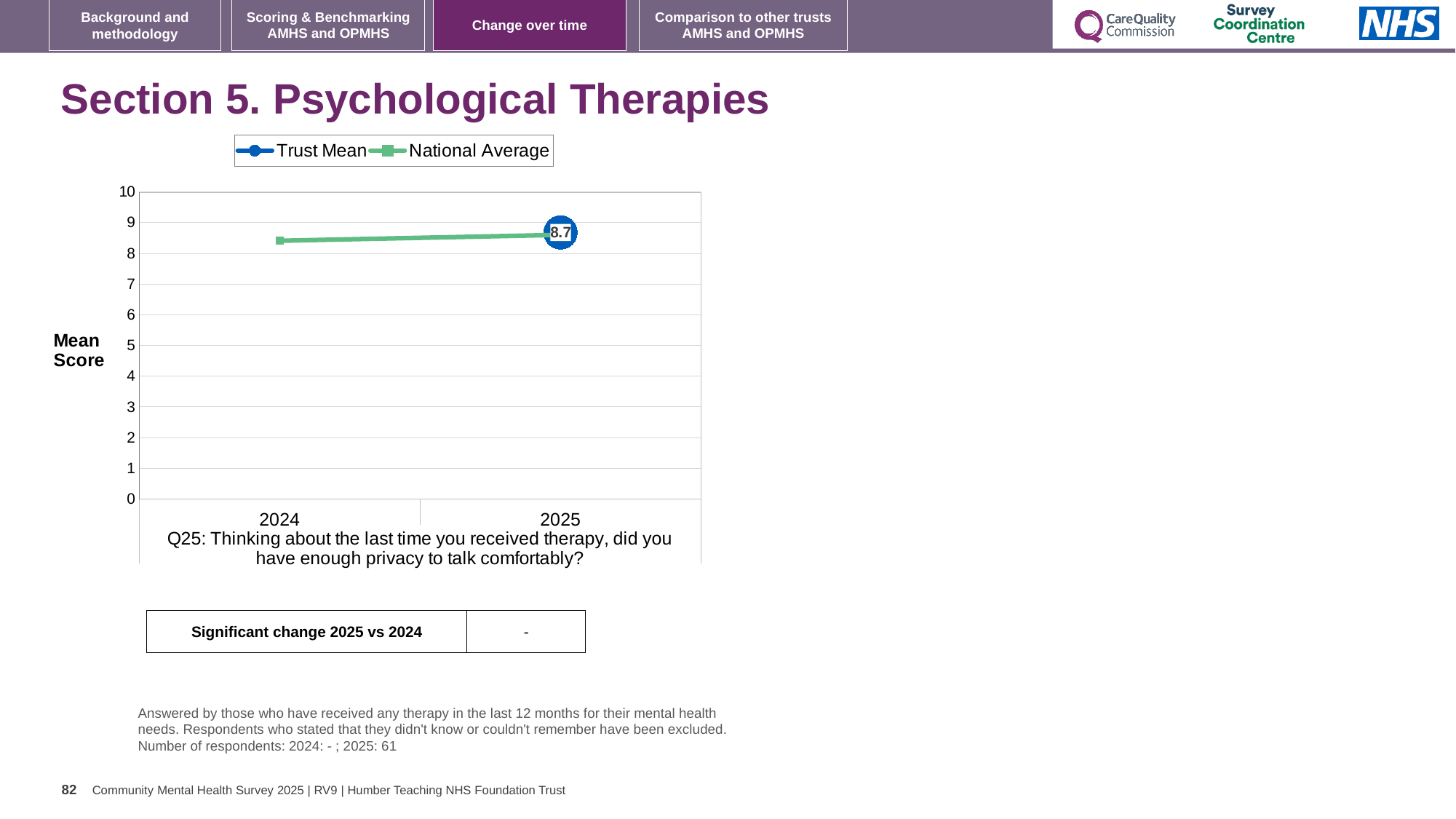
How many years are shown on the x axis? 2 How many series does the legend list? 2 What kind of chart is shown on the slide? line chart What is the Trust Mean value for 2025? 8.7 Is the National Average value for 2024 greater or less than 9? less Which series is shown in green in the legend? National Average Does the National Average rise or fall from 2024 to 2025? rise What is the highest value shown on the y axis? 10 Is the National Average value for 2024 greater or less than 8? greater Is the Trust Mean value for 2025 greater or less than 8? greater What is the label on the y axis of the chart? Mean Score